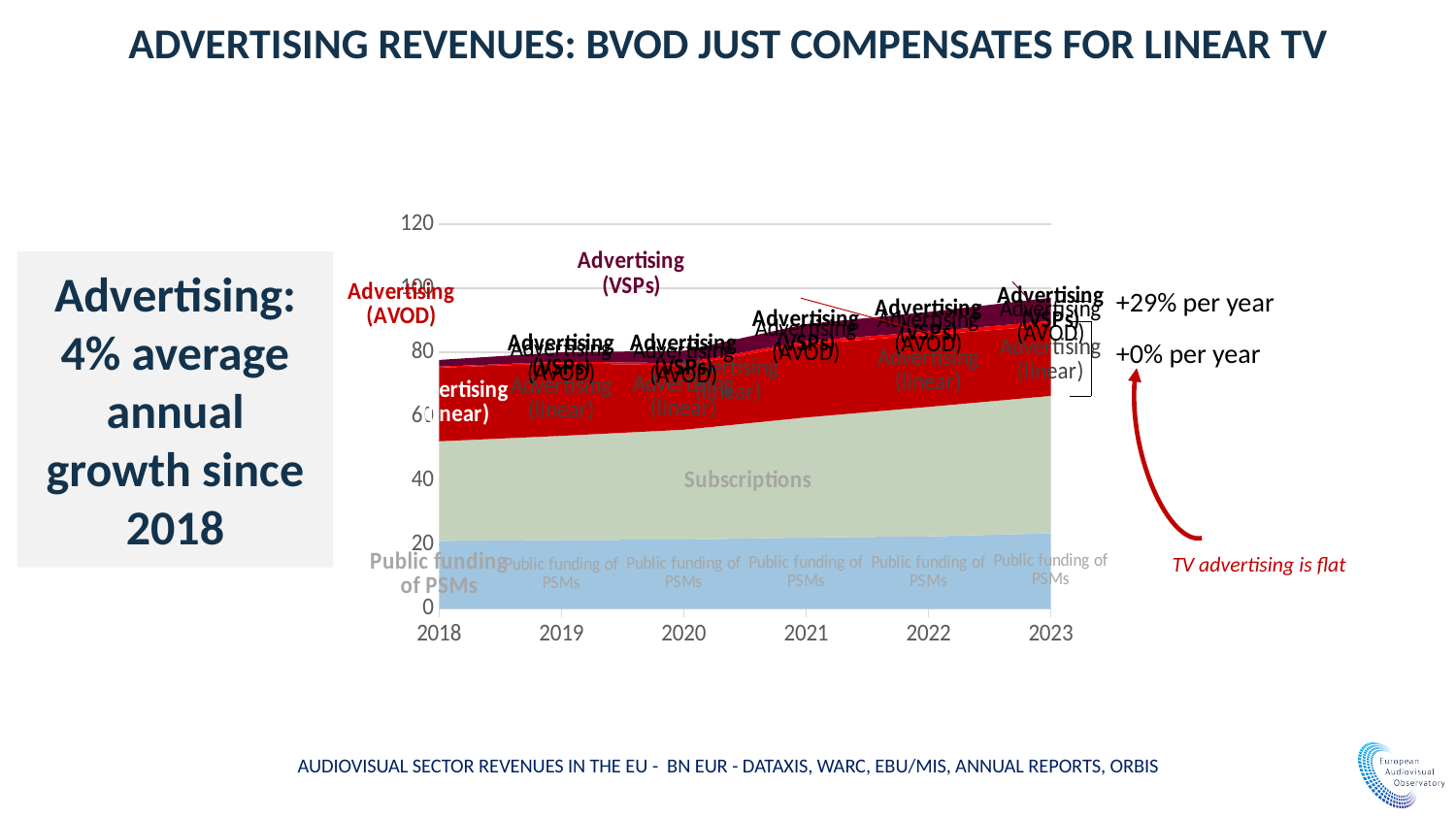
Is the total of all stacked series in 2018 greater or less than 100? less How many years are shown on the x axis of the chart? 6 Is the top of the Public funding of PSMs area in 2023 greater or less than 40? less What is the last year shown on the x axis of the chart? 2023 What annual growth rate is annotated next to the top of the chart for 2023? +29% per year Does the total of all stacked series rise or fall from 2018 to 2023? Rise Is the total of all stacked series larger in 2023 or in 2018? 2023 Is the total of all stacked series in 2023 greater or less than 80? greater What is the first year shown on the x axis of the chart? 2018 What kind of chart is shown on the slide? Stacked area chart Which series forms the bottom layer of the stacked area chart? Public funding of PSMs